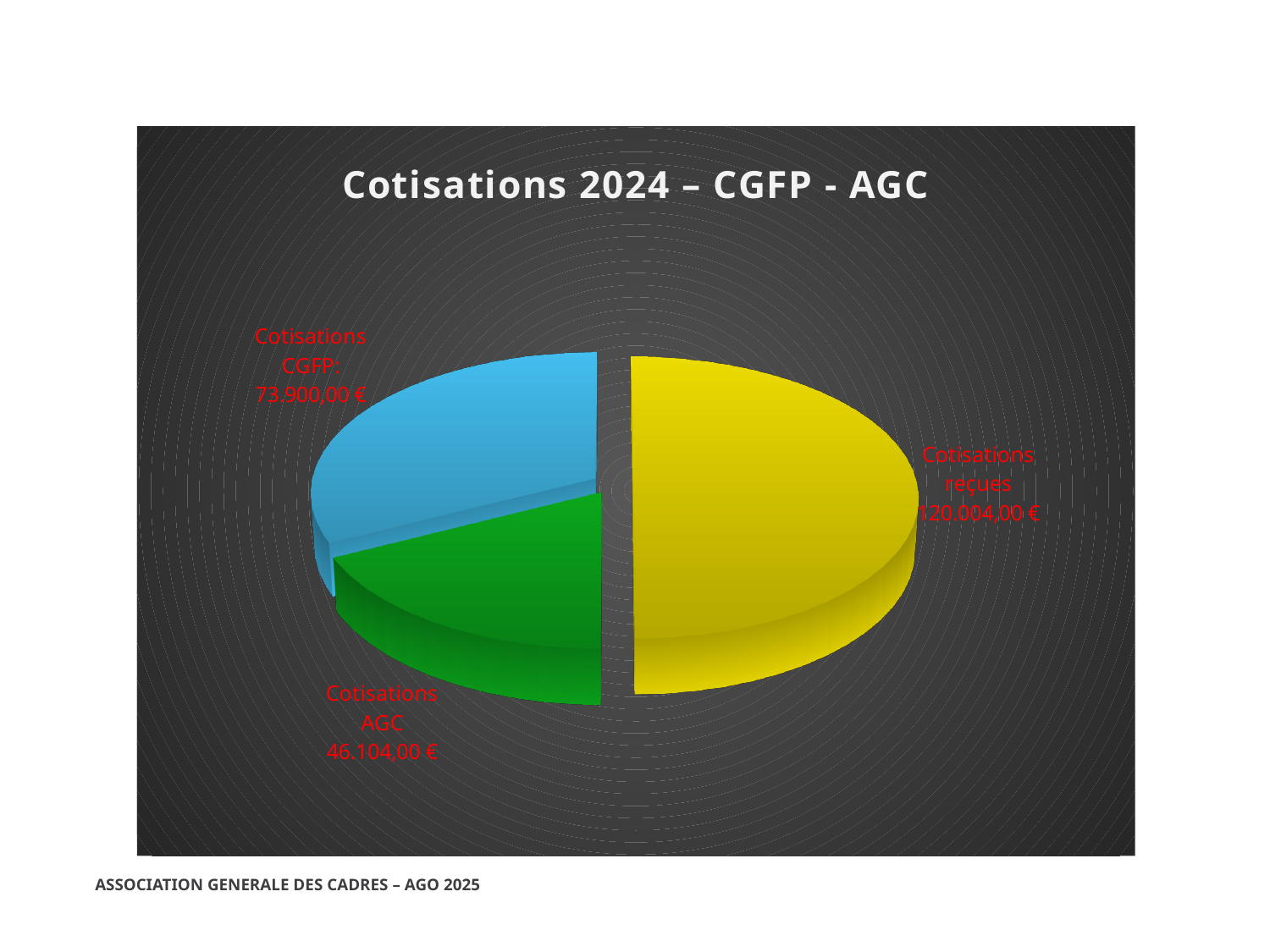
What is the difference between Cotisations reçues and Cotisations CGFP? 46.104,00 € What is the difference between Cotisations CGFP and Cotisations AGC? 27.796,00 € What is the value shown for Cotisations reçues? 120.004,00 € Which slice of the pie chart has the largest value? Cotisations reçues What type of chart is shown on the slide? Pie chart What is the value shown for Cotisations AGC? 46.104,00 € What is the value shown for Cotisations CGFP? 73.900,00 € What is the title of the chart? Cotisations 2024 – CGFP - AGC Which slice of the pie chart has the smallest value? Cotisations AGC How many slices does the pie chart have? 3 What colour is the Cotisations reçues slice? Yellow Which is larger, Cotisations CGFP or Cotisations AGC? Cotisations CGFP